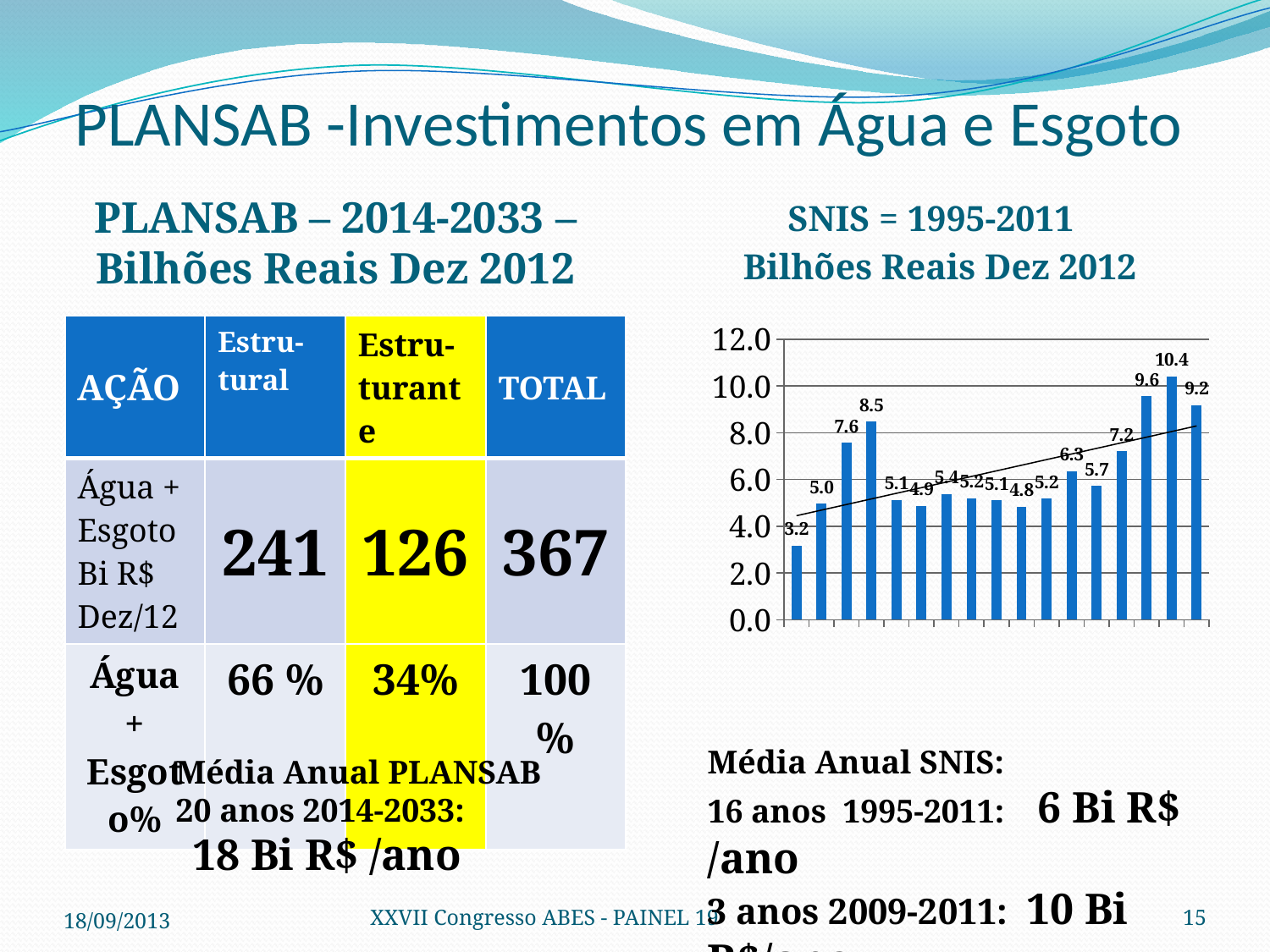
In the SNIS bar chart, which is larger: the first bar or the last bar? the last bar In the SNIS bar chart, what is the difference between the highest bar value and the lowest bar value? 7.2 In the SNIS bar chart, what is the value labelled on the first (leftmost) bar? 3.2 In the SNIS bar chart, what is the highest value labelled on any bar? 10.4 In the SNIS bar chart, what is the value labelled on the last (rightmost) bar? 9.2 In the SNIS bar chart, what is the lowest value labelled on any bar? 3.2 In the SNIS bar chart, is the value of the tallest bar greater or less than 10.0? greater In the SNIS bar chart, do the values generally rise or fall from left to right? rise What is the maximum value shown on the vertical axis of the SNIS bar chart? 12.0 In the SNIS bar chart, what is the difference between the tallest bar (10.4) and the rightmost bar (9.2)? 1.2 What kind of chart is shown on the right side of the slide under 'SNIS = 1995-2011'? bar chart How many bars are plotted in the SNIS bar chart? 17